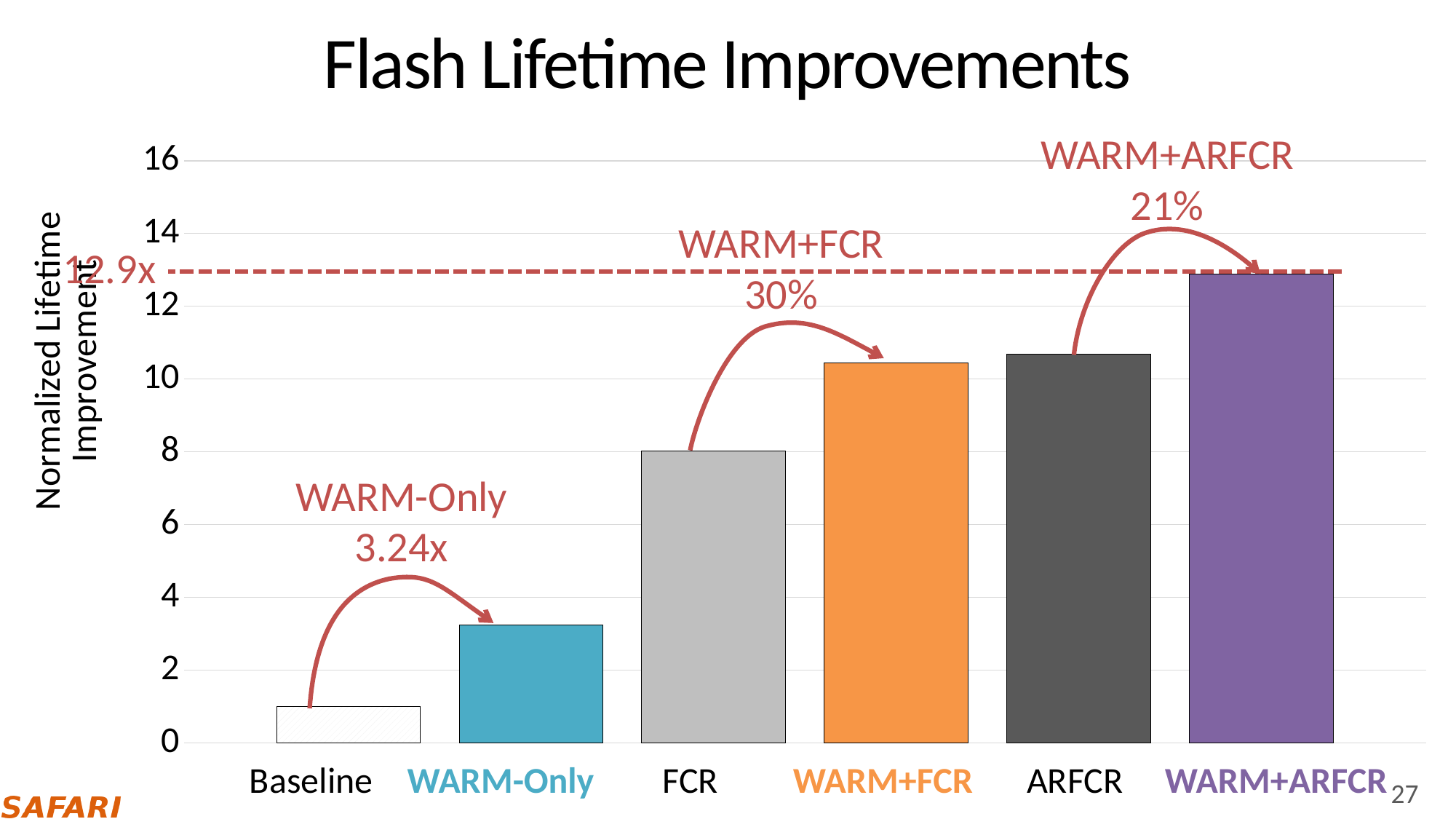
What kind of chart is shown on the slide? bar chart How many categories are plotted on the x axis? 6 What value does the dashed line at the top of the WARM+ARFCR bar mark? 12.9x Which is larger, the value for FCR or the value for WARM+FCR? WARM+FCR Is the value for WARM+FCR greater or less than 10? greater What lifetime improvement is annotated for WARM-Only? 3.24x What is the title of the chart? Flash Lifetime Improvements Is the value for Baseline greater or less than 2? less What percentage improvement is annotated from FCR to WARM+FCR? 30% Which category has the highest normalized lifetime improvement? WARM+ARFCR Which category has the lowest normalized lifetime improvement? Baseline What percentage improvement is annotated from ARFCR to WARM+ARFCR? 21%